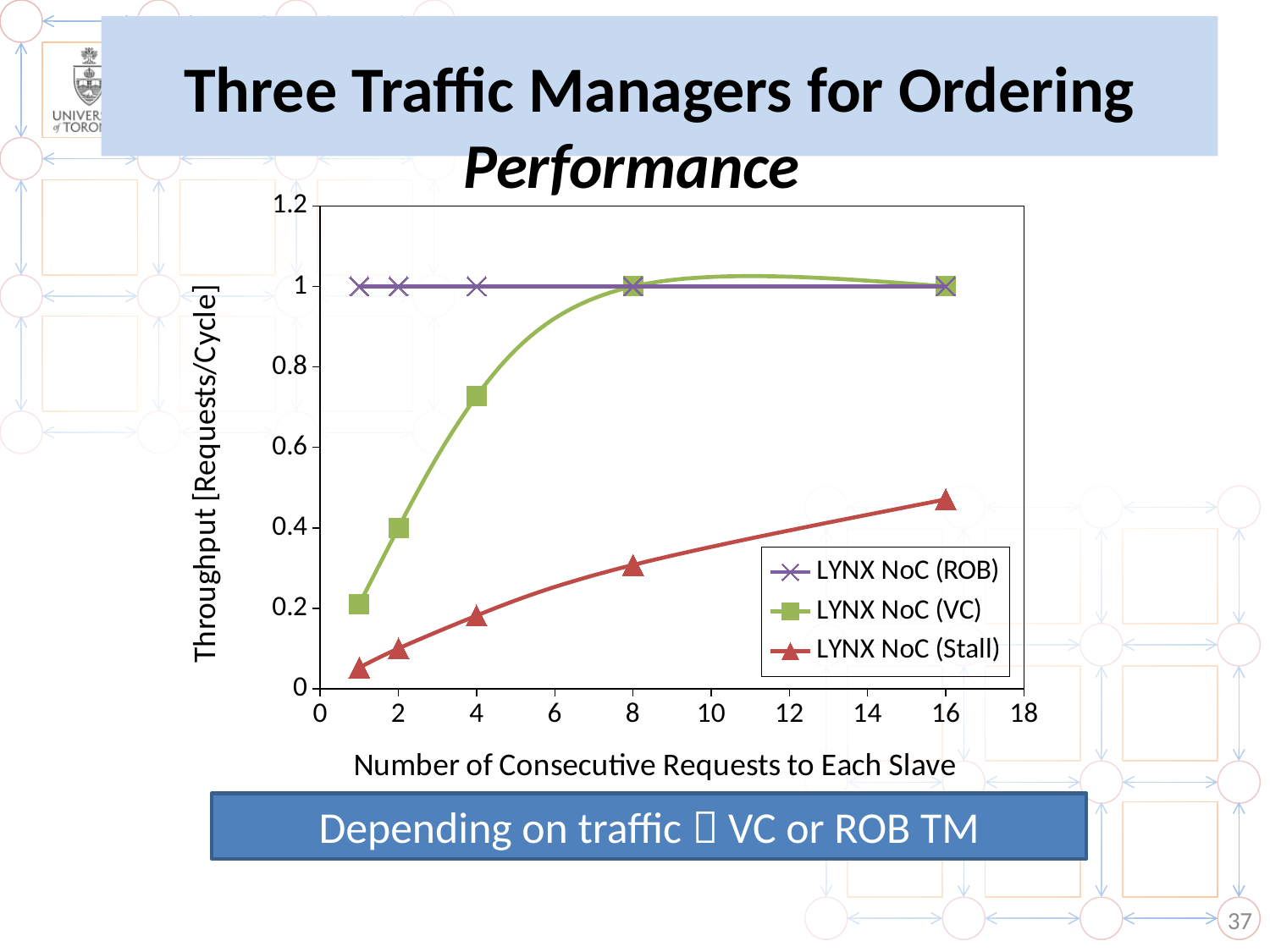
Is the throughput of LYNX NoC (Stall) at 8 consecutive requests greater or less than 0.4? less What is the throughput of LYNX NoC (VC) at 16 consecutive requests to each slave? 1 Which series has the lowest throughput at 1 consecutive request to each slave? LYNX NoC (Stall) How many data points are plotted for the LYNX NoC (Stall) series? 5 Is the throughput of LYNX NoC (Stall) at 16 consecutive requests greater or less than 0.4? greater What kind of chart is shown on the slide? line chart How many series does the legend list? 3 What is the throughput of LYNX NoC (ROB) at 4 consecutive requests to each slave? 1 Is the throughput of LYNX NoC (VC) at 2 consecutive requests greater or less than 0.6? less Does the throughput of LYNX NoC (Stall) rise or fall as the number of consecutive requests increases? rise Which series has the highest throughput at 2 consecutive requests to each slave? LYNX NoC (ROB) At 4 consecutive requests, which has higher throughput: LYNX NoC (VC) or LYNX NoC (Stall)? LYNX NoC (VC)